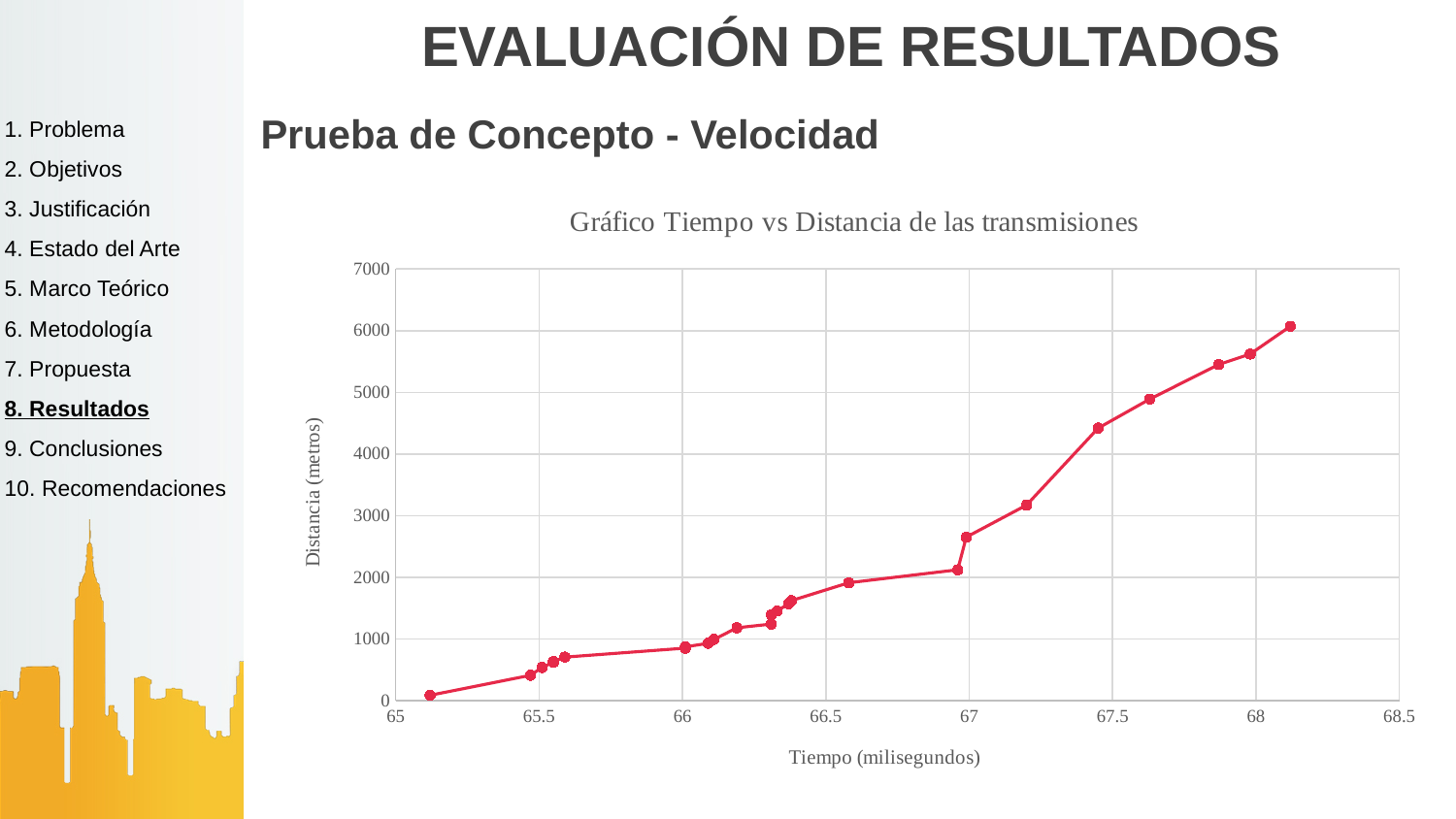
Is the distance value of the rightmost point (at about 68.1 milliseconds) greater or less than 5000? greater Is the distance value of the leftmost point (at about 65.1 milliseconds) greater or less than 1000? less What is the highest value shown on the y axis? 7000 Is the distance value of the point at about 67.45 milliseconds greater or less than 4000? greater Which point has the highest distance value: the one at about 67.2 milliseconds or the one at about 67.63 milliseconds? the one at about 67.63 milliseconds Do the distance values rise or fall as time increases along the x axis? rise What kind of chart is shown on the slide? line chart What is the label of the x axis? Tiempo (milisegundos) What is the title of the chart? Gráfico Tiempo vs Distancia de las transmisiones How many data series are plotted on the chart? 1